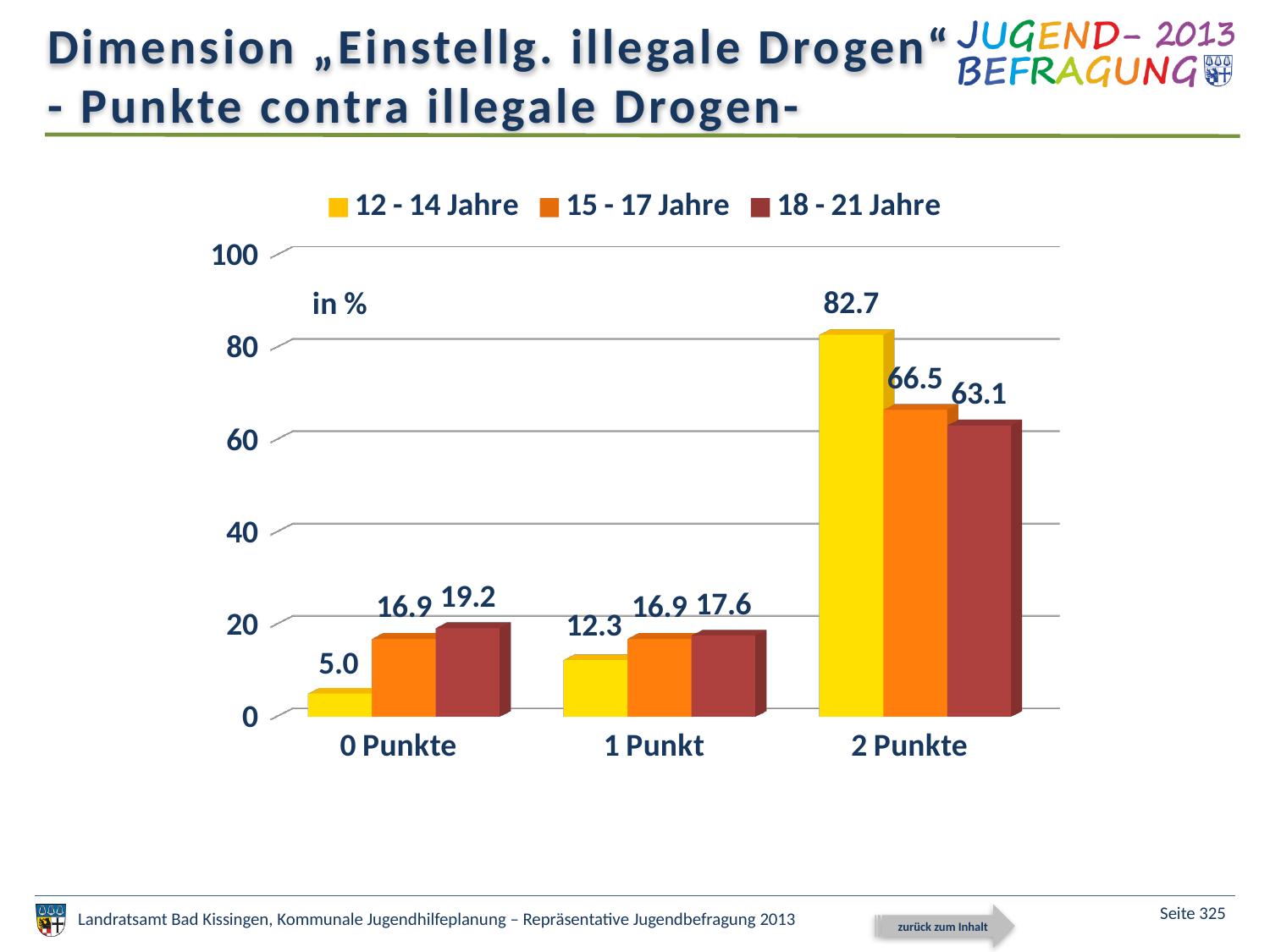
What kind of chart is shown on the slide? bar chart What is the value for the 15 - 17 Jahre series at 1 Punkt? 16.9 What unit is indicated for the values on the chart? in % What is the value for the 12 - 14 Jahre series at 2 Punkte? 82.7 How many categories are shown on the x axis? 3 Which age group has the highest value at 2 Punkte? 12 - 14 Jahre How many series does the legend list? 3 Which age group has the lowest value at 0 Punkte? 12 - 14 Jahre What is the value for the 18 - 21 Jahre series at 0 Punkte? 19.2 What is the difference between the 12 - 14 Jahre and 18 - 21 Jahre values at 2 Punkte? 19.6 Is the value for 15 - 17 Jahre at 2 Punkte greater or less than 60? greater Which is larger at 1 Punkt: the value for 15 - 17 Jahre or for 18 - 21 Jahre? 18 - 21 Jahre